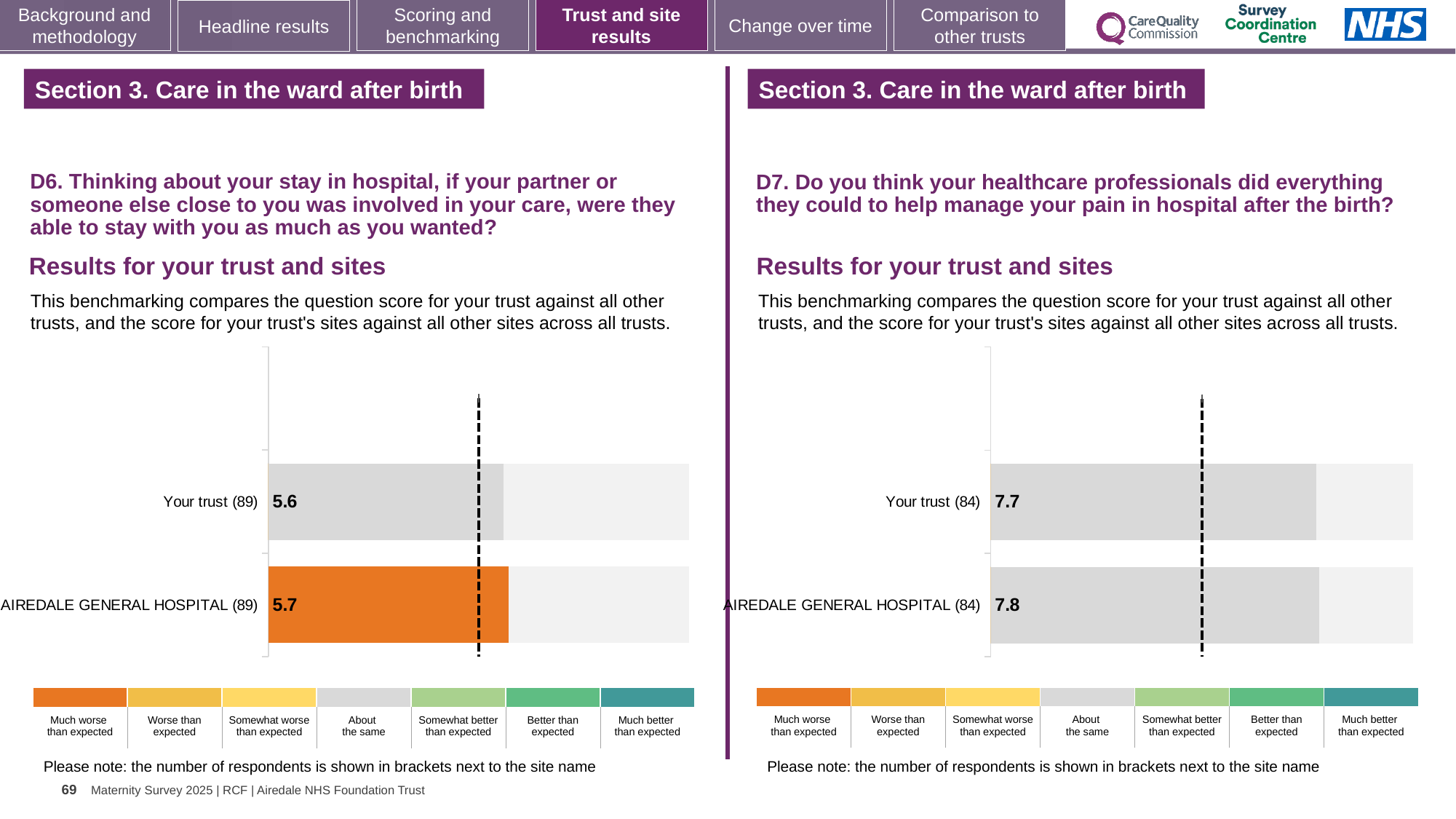
What kind of chart is used for the D6 results on the left? Bar chart In the D6 chart on the left, how many respondents are shown in brackets for Your trust? 89 In the D7 chart on the right, what is the score for Airedale General Hospital? 7.8 In the D7 chart on the right, what is the difference between the Airedale General Hospital score and the Your trust score? 0.1 In the D6 chart on the left, which benchmark category does the orange colour of the Airedale General Hospital bar represent? Much worse than expected In the D6 chart on the left, what is the score for Airedale General Hospital? 5.7 In the D7 chart on the right, what is the score for Your trust? 7.7 In the D7 chart on the right, how many respondents are shown in brackets for Airedale General Hospital? 84 How many bars are plotted in the D7 chart on the right? 2 In the D6 chart on the left, what is the difference between the Airedale General Hospital score and the Your trust score? 0.1 In the D6 chart on the left, what is the score for Your trust? 5.6 In the D6 chart on the left, which has the higher score, Your trust or Airedale General Hospital? Airedale General Hospital